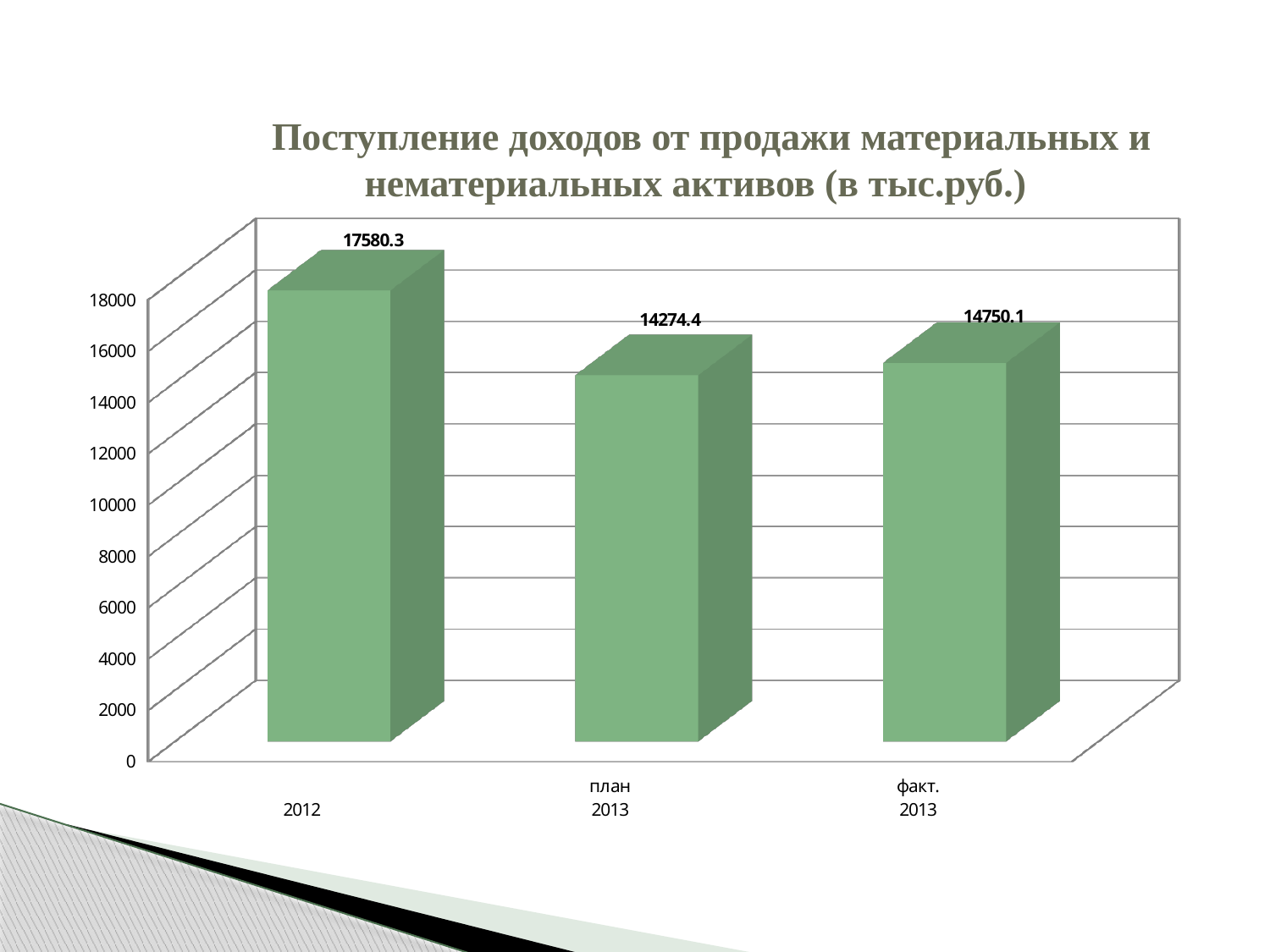
What kind of chart is shown on the slide? bar chart Which category has the lowest value? план 2013 Is the value for 2012 greater or less than 16000? greater Which is larger, the value for план 2013 or the value for факт. 2013? факт. 2013 How many bars are shown in the chart? 3 What is the difference between the values for факт. 2013 and план 2013? 475.7 What unit is stated in the chart title? тыс.руб. What is the difference between the values for 2012 and план 2013? 3305.9 What is the value for 2012? 17580.3 Which category has the highest value? 2012 What is the value for план 2013? 14274.4 What is the value for факт. 2013? 14750.1